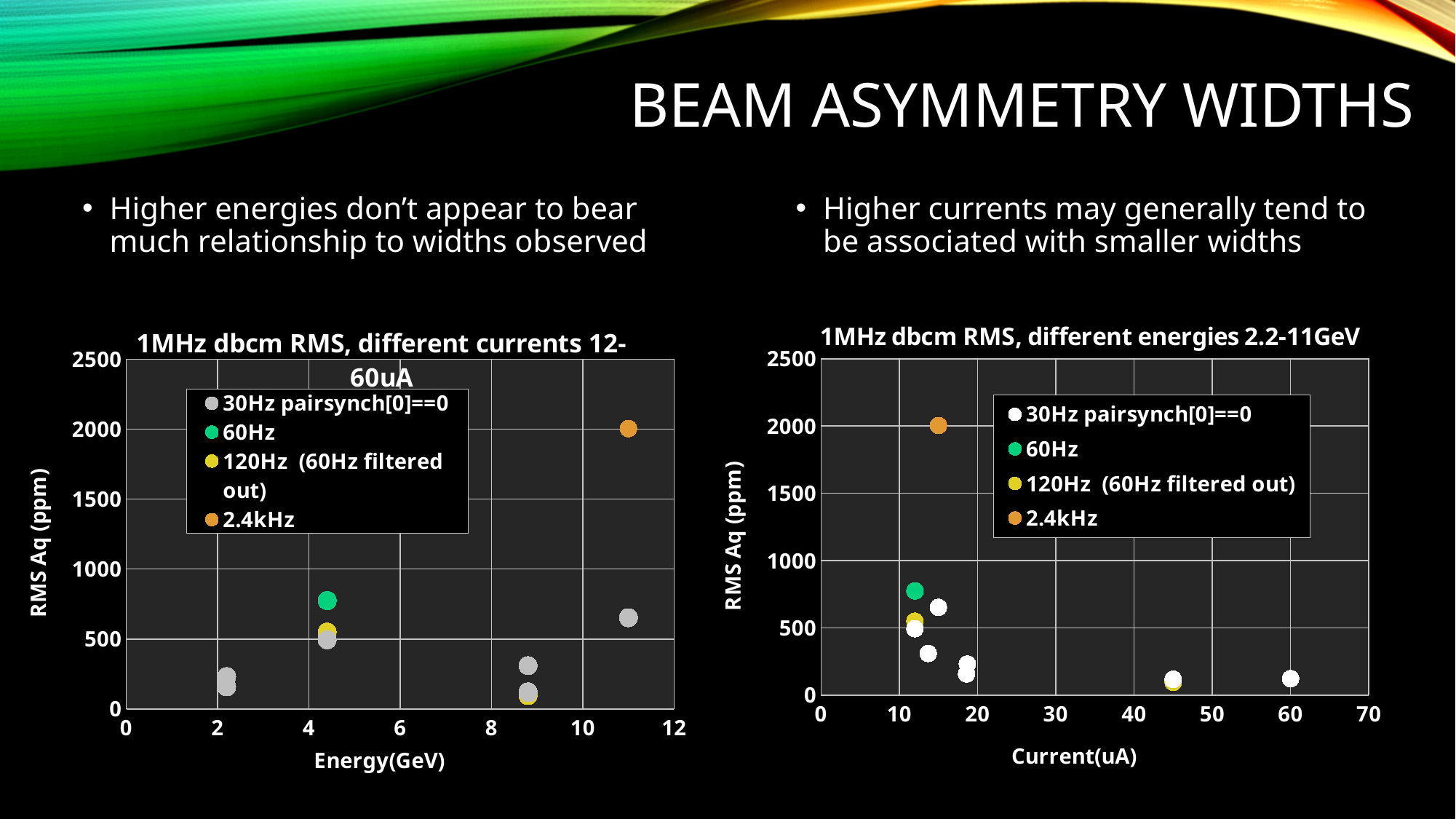
In the left chart '1MHz dbcm RMS, different currents 12-60uA', is the value of the 60Hz point greater or less than 1000? less In the right chart '1MHz dbcm RMS, different energies 2.2-11GeV', is the value of the 30Hz pairsynch[0]==0 point at 60 uA greater or less than 500? less How many series does the legend of the right chart '1MHz dbcm RMS, different energies 2.2-11GeV' list? 4 In the left chart '1MHz dbcm RMS, different currents 12-60uA', which series has the highest plotted point? 2.4kHz In the right chart '1MHz dbcm RMS, different energies 2.2-11GeV', which series has the highest plotted point? 2.4kHz What is the x-axis title of the right chart '1MHz dbcm RMS, different energies 2.2-11GeV'? Current(uA) In the left chart '1MHz dbcm RMS, different currents 12-60uA', which is larger at about 4.4 GeV: the 60Hz point or the 120Hz (60Hz filtered out) point? 60Hz How many 2.4kHz points are plotted in the right chart '1MHz dbcm RMS, different energies 2.2-11GeV'? 1 What kind of chart is the left chart titled '1MHz dbcm RMS, different currents 12-60uA'? scatter chart In the left chart '1MHz dbcm RMS, different currents 12-60uA', is the value of the 2.4kHz point greater or less than 1500? greater What is the x-axis title of the left chart '1MHz dbcm RMS, different currents 12-60uA'? Energy(GeV) In the right chart '1MHz dbcm RMS, different energies 2.2-11GeV', do the 30Hz pairsynch[0]==0 values generally rise or fall as current increases? fall